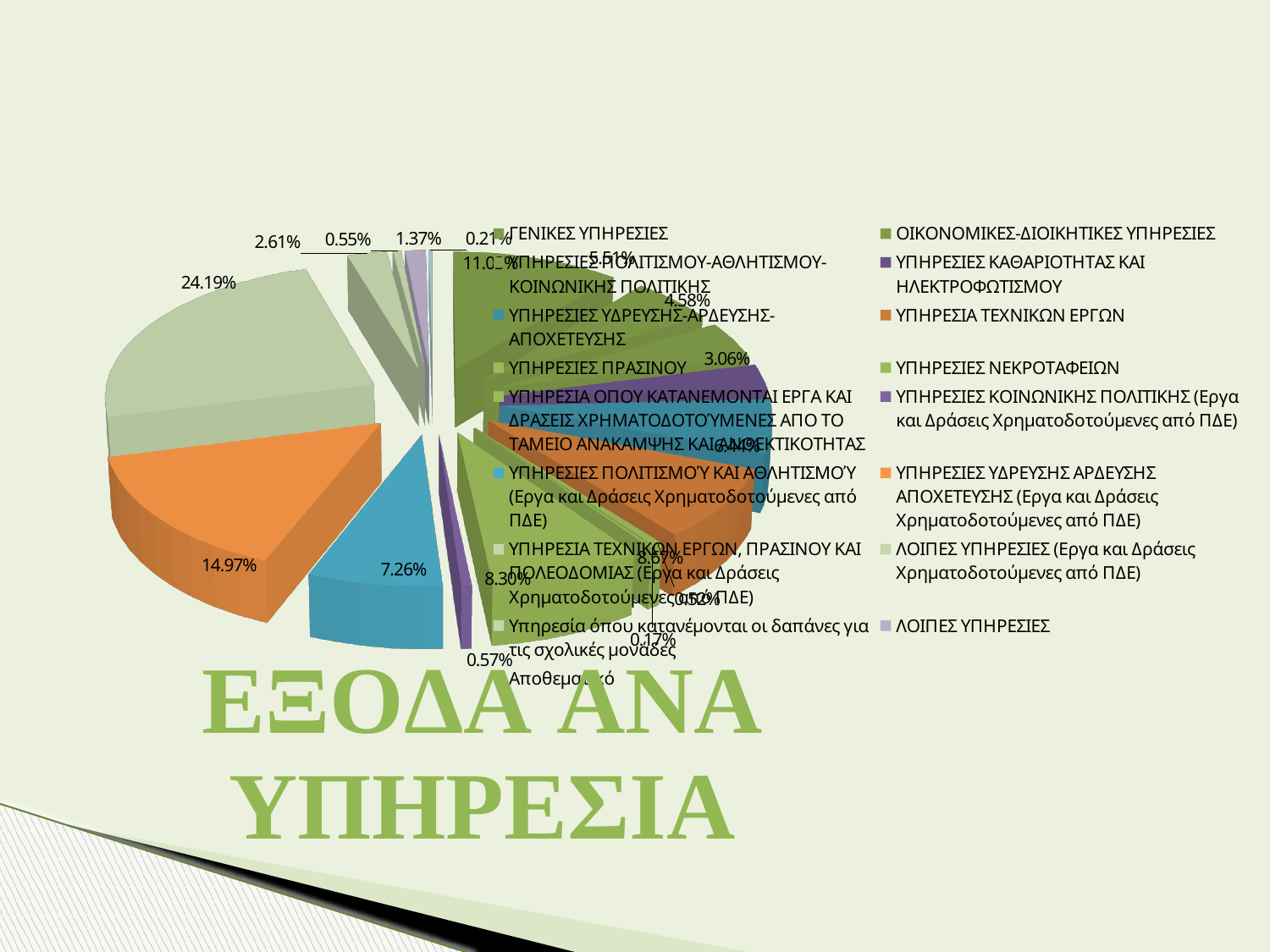
Which is larger, the slice labelled 24.19% or the slice labelled 14.97%? 24.19% What is the largest percentage shown as a data label on the pie chart? 24.19% What is the title shown on the slide for this chart? ΕΞΟΔΑ ΑΝΑ ΥΠΗΡΕΣΙΑ What is the first entry listed in the legend of the pie chart? ΓΕΝΙΚΕΣ ΥΠΗΡΕΣΙΕΣ What kind of chart is shown on the slide? Pie chart What is the smallest percentage shown as a data label on the pie chart? 0.17% What is the difference between the slice labelled 14.97% and the slice labelled 7.26%? 7.71% What percentage is shown on the large orange slice of the pie chart? 14.97% What percentage is shown on the blue slice at the bottom of the pie chart? 7.26% What is the difference between the slice labelled 24.19% and the slice labelled 14.97%? 9.22% How many entries does the legend of the pie chart list? 17 Is the largest slice of the pie chart greater or less than 20%? greater